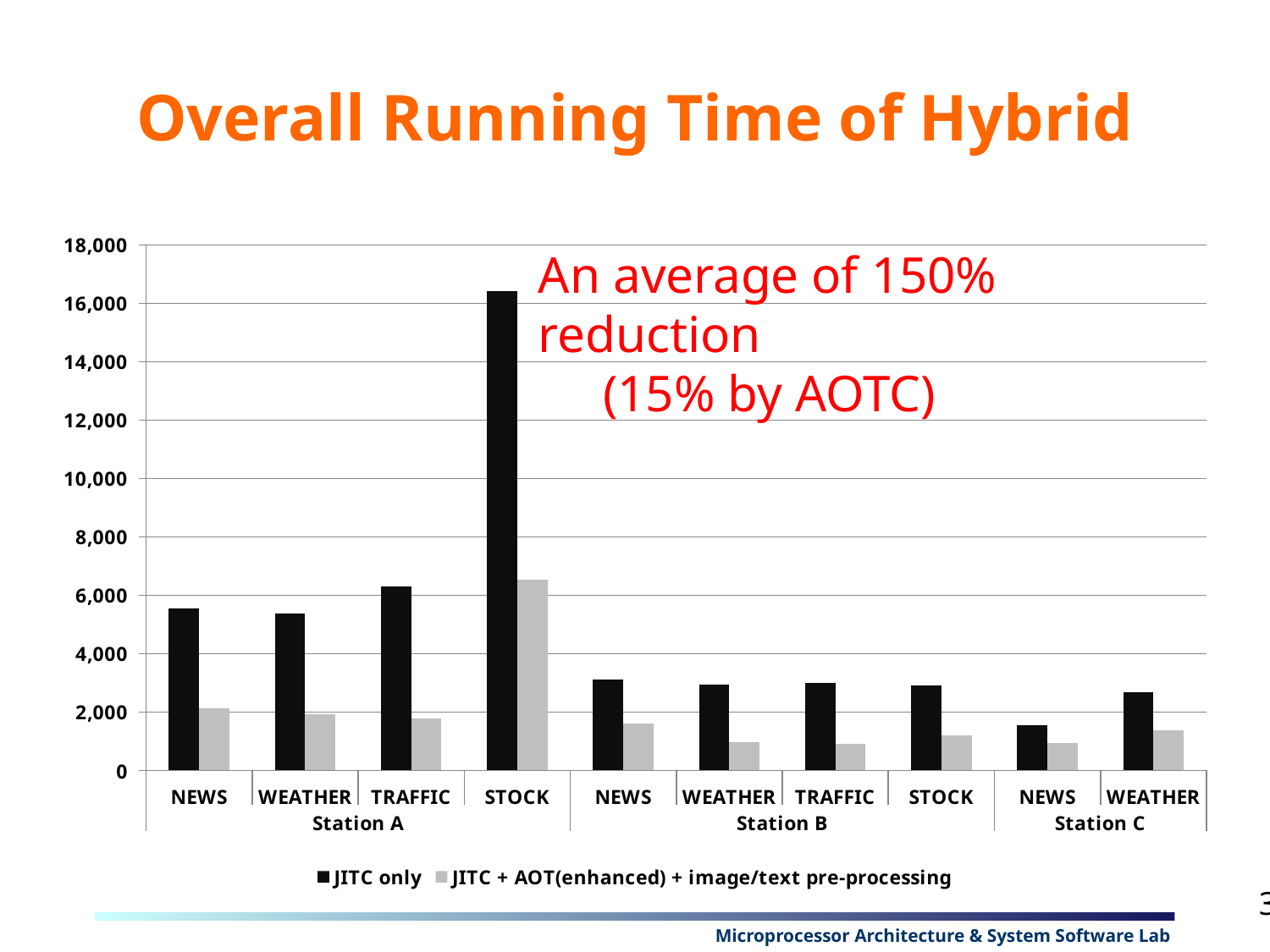
What is the title of the chart? Overall Running Time of Hybrid How many categories (bar groups) are plotted along the x axis? 10 Which category has the lowest 'JITC only' value? NEWS (Station C) What kind of chart is shown on the slide? bar chart Is the 'JITC only' value for NEWS at Station A greater or less than 6,000? less How many series does the legend list? 2 Is the 'JITC + AOT(enhanced) + image/text pre-processing' value for STOCK at Station A greater or less than 6,000? greater Is the 'JITC only' value for NEWS at Station C greater or less than 2,000? less Which category has the highest 'JITC only' value? STOCK (Station A) Which is larger for NEWS at Station B: the 'JITC only' bar or the 'JITC + AOT(enhanced) + image/text pre-processing' bar? JITC only Which is larger: the 'JITC only' value for TRAFFIC at Station A or the 'JITC only' value for NEWS at Station A? TRAFFIC at Station A